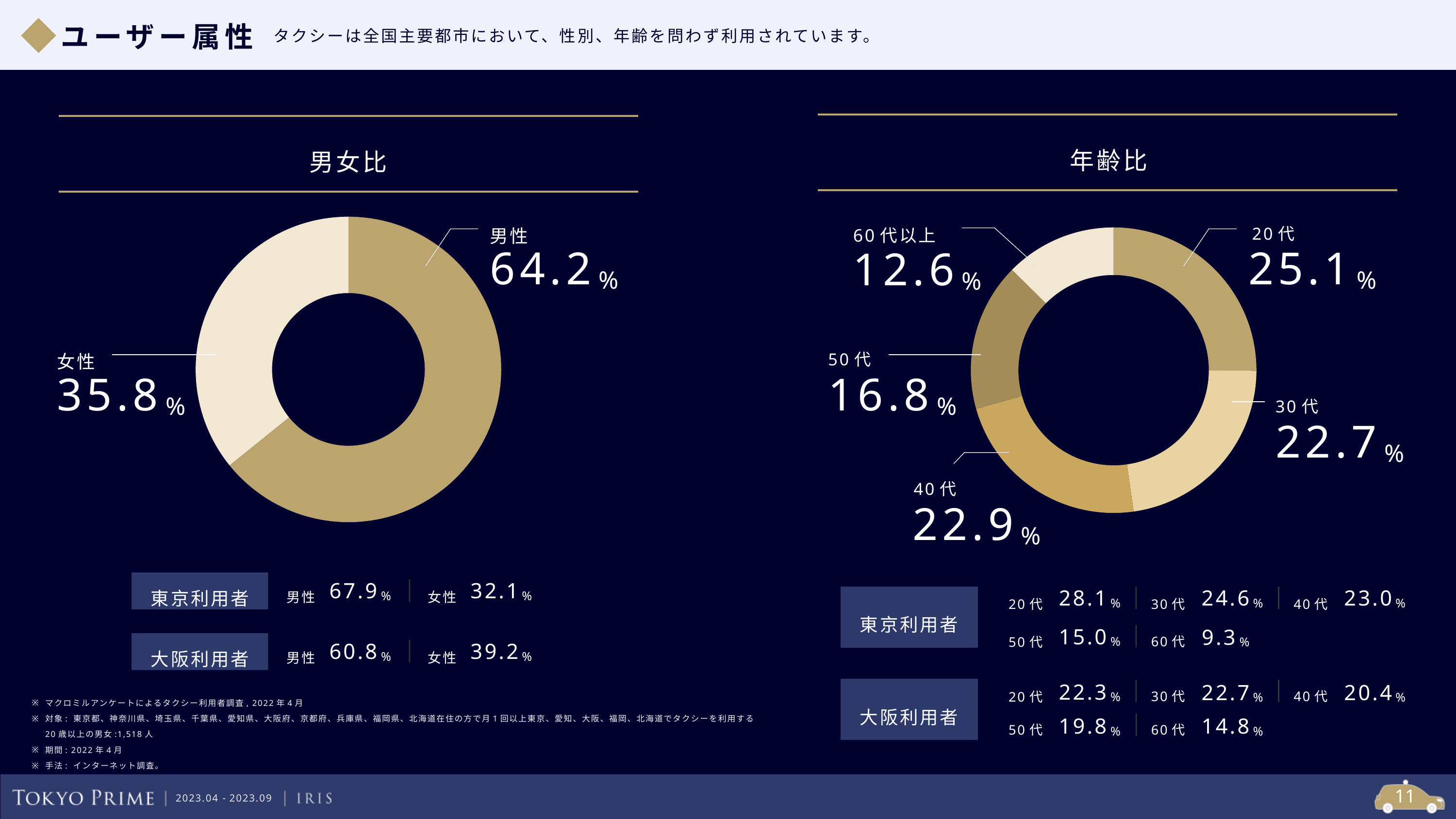
In the 年齢比 chart, which age group has the smallest share? 60代以上 In the 年齢比 chart, which is larger, the share for 30代 or the share for 50代? 30代 In the 年齢比 chart, what is the value for 20代? 25.1% In the 男女比 chart, what is the value for 男性? 64.2% In the 年齢比 chart, what is the value for 50代? 16.8% In the 年齢比 chart, how many age categories are shown? 5 In the 男女比 chart, what is the difference between the 男性 and 女性 shares? 28.4% In the 年齢比 chart, what is the difference between the 20代 and 60代以上 shares? 12.5% In the 年齢比 chart, which age group has the largest share? 20代 In the 男女比 chart, what is the value for 女性? 35.8% What kind of chart is the 男女比 chart? Donut (pie) chart In the 年齢比 chart, what is the value for 60代以上? 12.6%